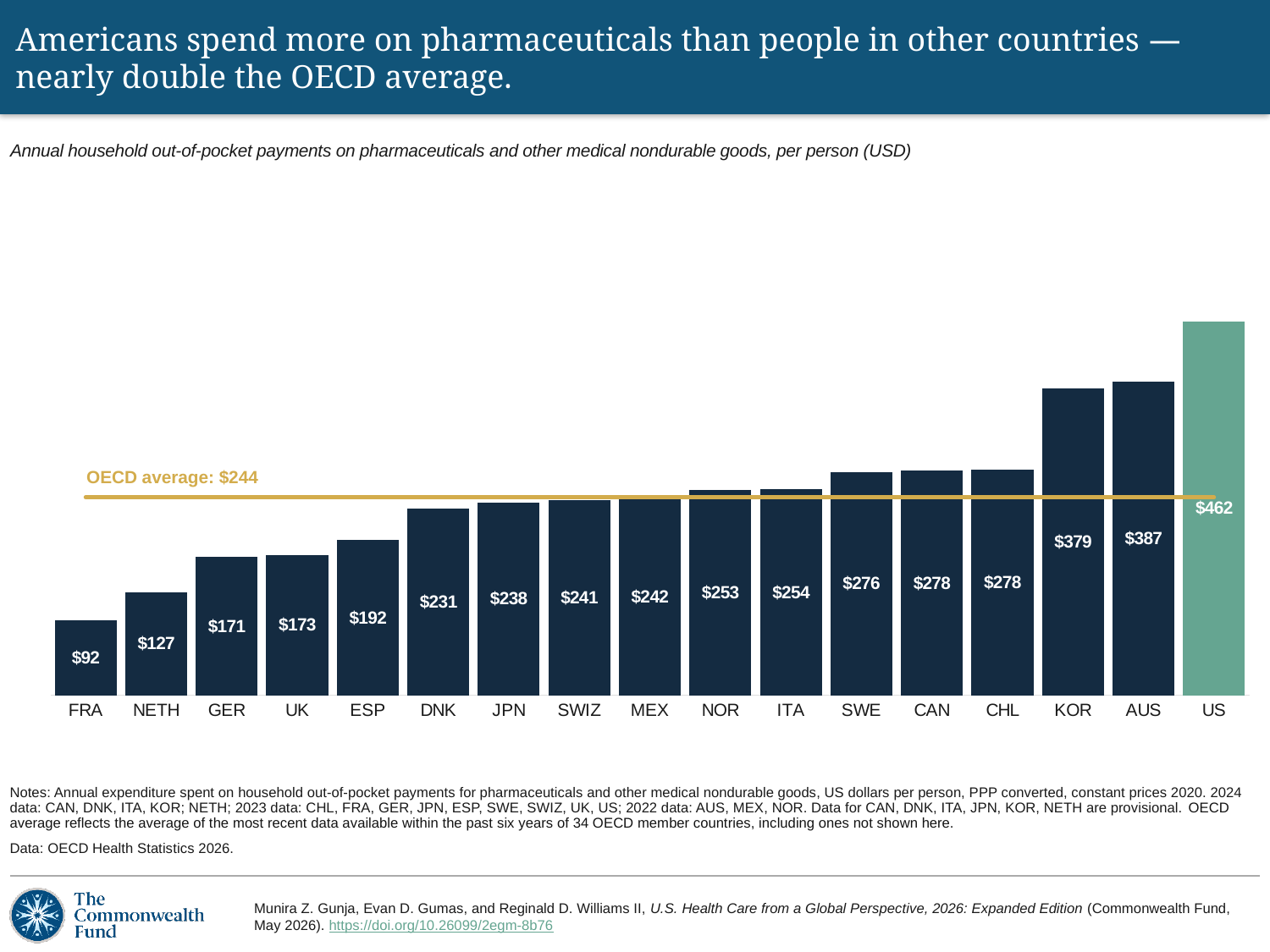
Do the values rise or fall moving from left to right along the x axis? Rise What is the difference between the US value and the Australia (AUS) value? $75 How many countries are shown on the chart? 17 What is the annual household out-of-pocket payment on pharmaceuticals per person for the US? $462 Which country has the lowest out-of-pocket pharmaceutical spending per person on the chart? FRA Which is larger, the value for Sweden (SWE) or the value for Norway (NOR)? SWE What is the value shown for Germany (GER)? $171 What is the value shown for Korea (KOR)? $379 What kind of chart is shown on the slide? Bar chart What OECD average value is marked by the horizontal line on the chart? $244 What is the difference between the Netherlands (NETH) value and the France (FRA) value? $35 Which country has the highest out-of-pocket pharmaceutical spending per person on the chart? US